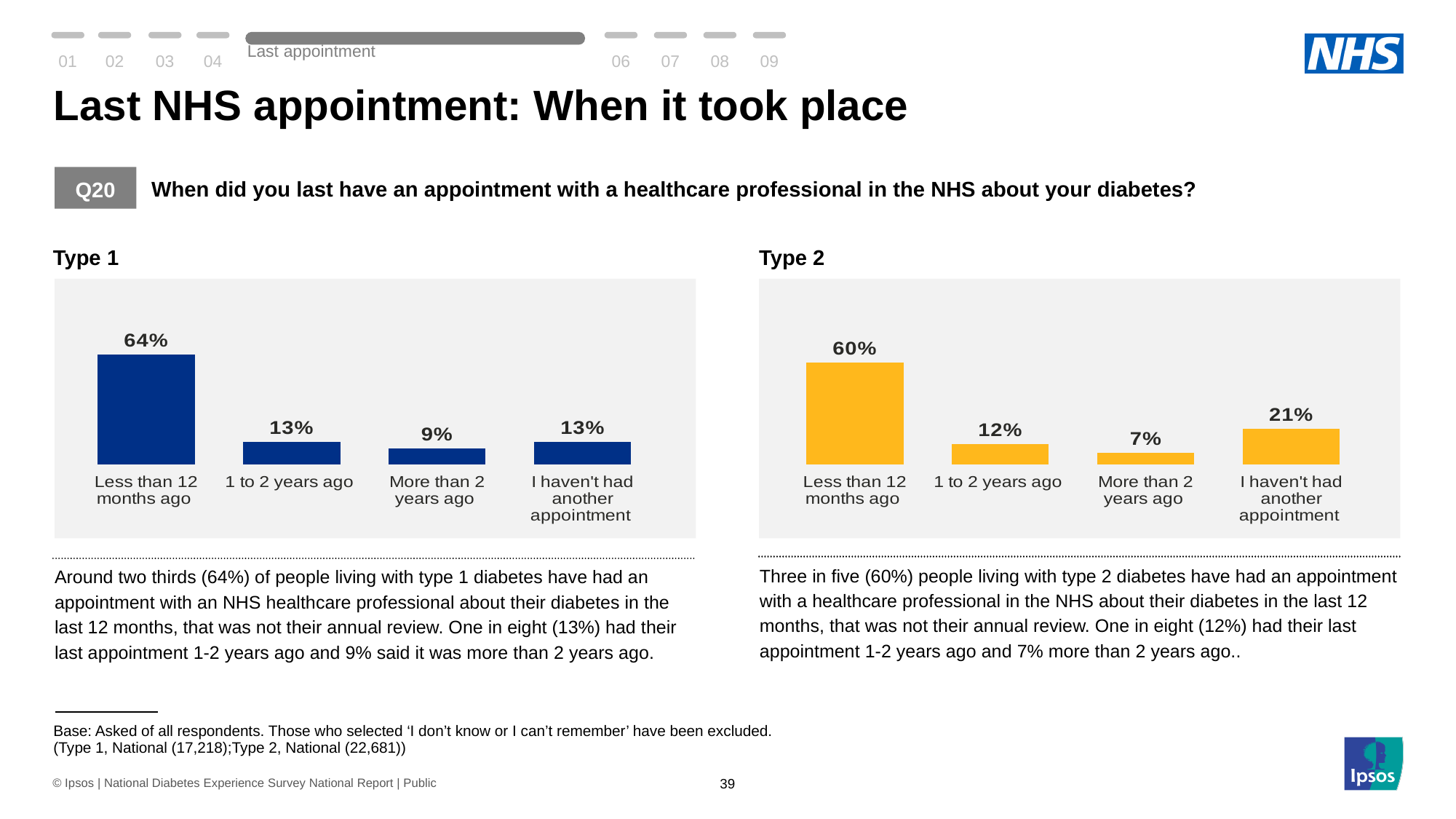
In the Type 1 chart, which category has the lowest value? More than 2 years ago How many categories are shown in the Type 1 chart? 4 Which is larger: the 'I haven't had another appointment' value in the Type 1 chart or in the Type 2 chart? Type 2 What colour are the bars in the Type 2 chart? Yellow What kind of chart is the Type 2 chart? Bar chart In the Type 1 chart, what percentage had their last appointment less than 12 months ago? 64% In the Type 2 chart, which category has the highest value? Less than 12 months ago In the Type 2 chart, what is the value for 'More than 2 years ago'? 7% In the Type 1 chart, what is the difference between '1 to 2 years ago' and 'More than 2 years ago'? 4 percentage points In the Type 2 chart, what is the difference between 'Less than 12 months ago' and 'I haven't had another appointment'? 39 percentage points In the Type 1 chart, is the value for '1 to 2 years ago' greater or less than the value for 'I haven't had another appointment'? Equal (both 13%) In the Type 2 chart, what percentage said they haven't had another appointment? 21%